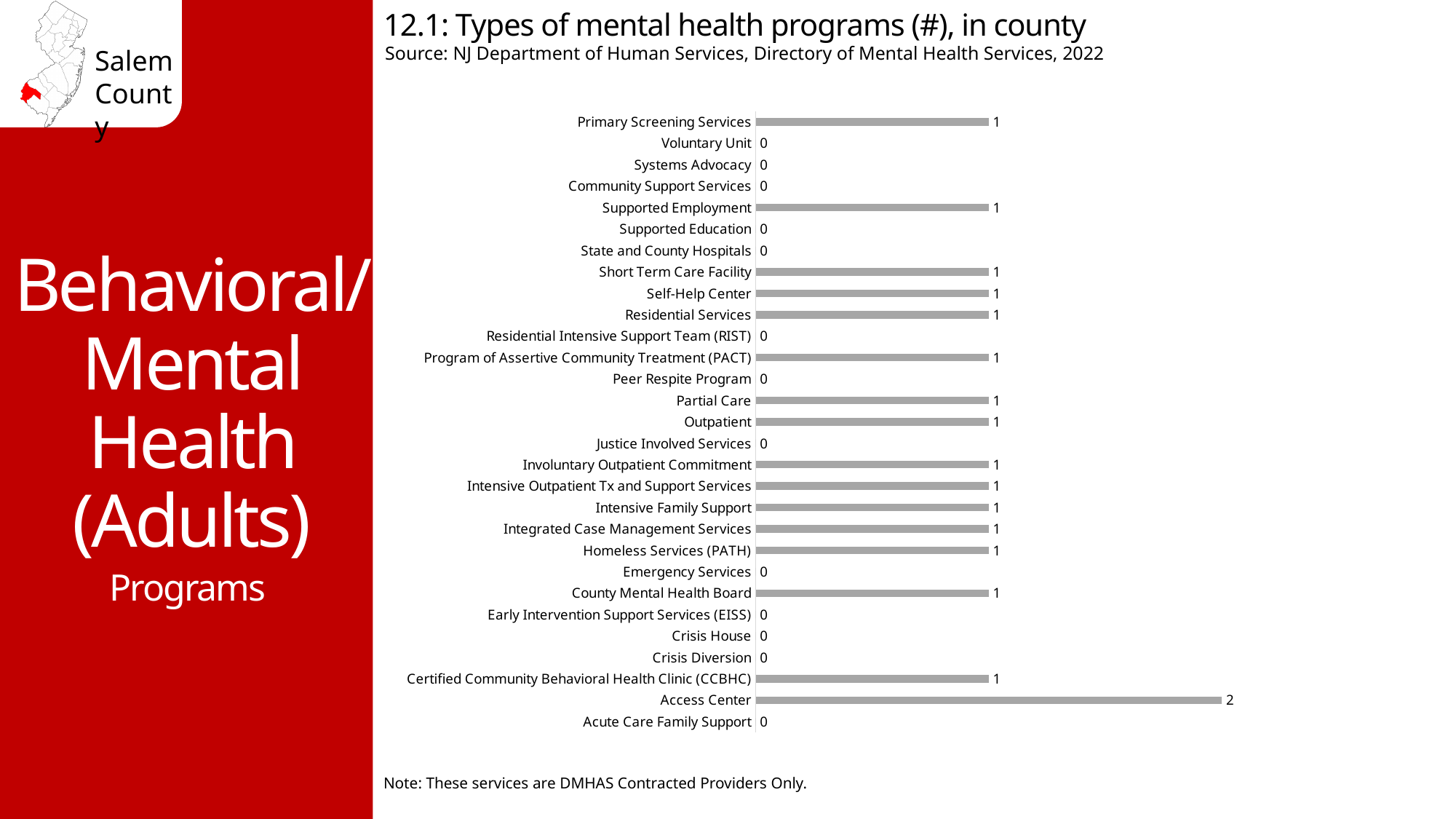
What is the title of the chart? 12.1: Types of mental health programs (#), in county What is the difference between the values for Access Center and Outpatient? 1 What is the value for Primary Screening Services? 1 How many categories are shown in the chart? 29 Which category has the highest value? Access Center What is the value for Crisis House? 0 What kind of chart is shown on the slide? Bar chart Which is larger, the value for Supported Employment or the value for Supported Education? Supported Employment How many categories have a value of 0? 13 What is the value for Access Center? 2 What is the value for Program of Assertive Community Treatment (PACT)? 1 What is the source cited for the chart? NJ Department of Human Services, Directory of Mental Health Services, 2022